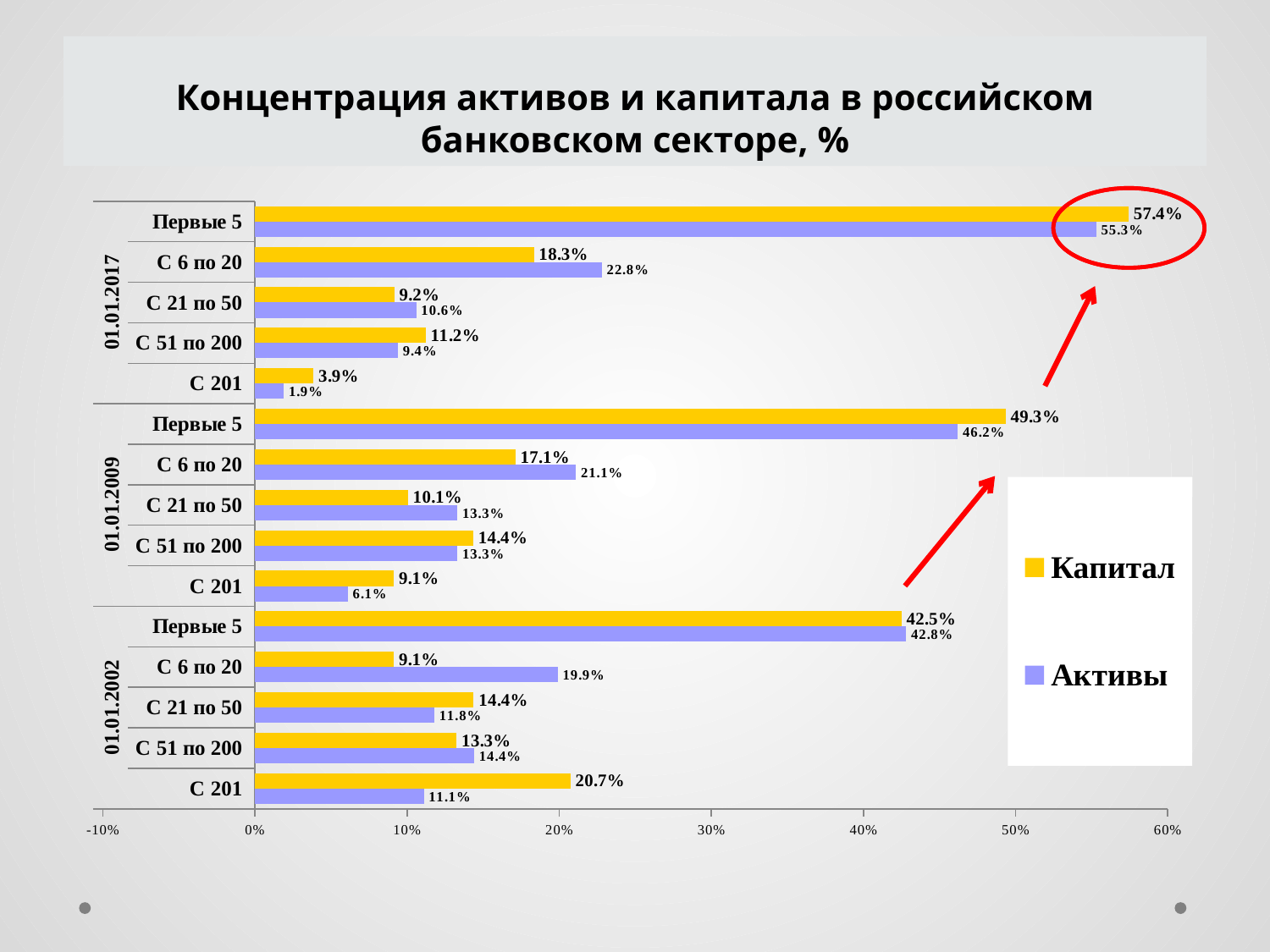
What kind of chart is shown on the slide? Bar chart For С 6 по 20 on 01.01.2002, which is larger: Капитал or Активы? Активы What is the difference between the Капитал and Активы values for Первые 5 on 01.01.2009? 3.1% How did the Капитал value for Первые 5 change from 01.01.2002 to 01.01.2017? It rose (42.5% to 57.4%) Which category has the highest Капитал value across the whole chart? Первые 5 (01.01.2017) What is the Активы value for С 201 on 01.01.2002? 11.1% What is the Капитал value for Первые 5 on 01.01.2017? 57.4% How many series does the legend list? 2 Which colour represents the Активы series in the legend? Blue (light purple) What is the Активы value for С 6 по 20 on 01.01.2009? 21.1% Which category has the lowest Активы value across the whole chart? С 201 (01.01.2017) Is the Активы value for Первые 5 on 01.01.2017 greater or less than 50%? greater